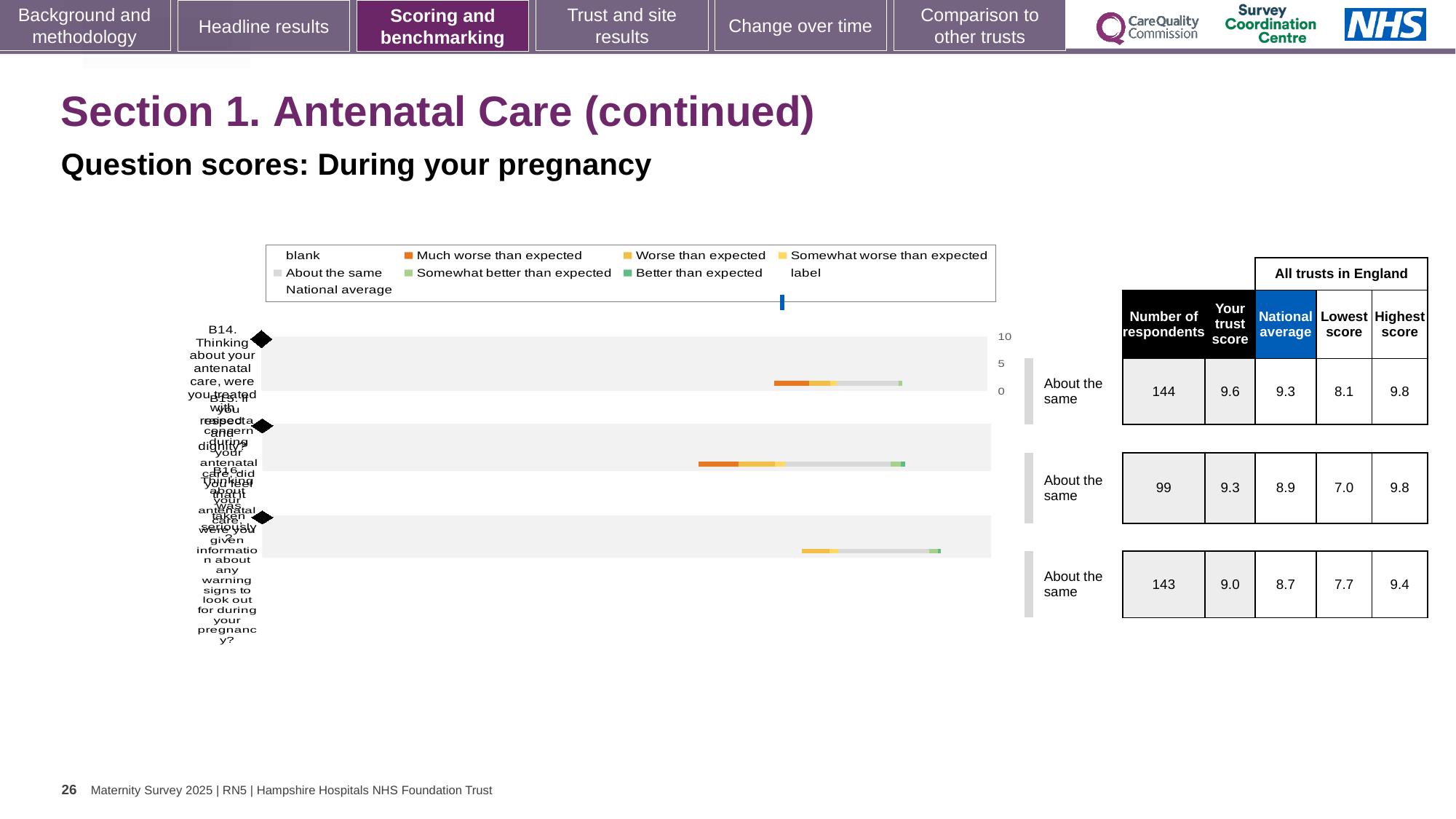
What is the difference between the trust score and the national average for question B14? 0.3 What is the national average for question B16? 8.7 What is the trust score for question B15? 9.3 What benchmark category is shown for all three questions? About the same Which question has the lowest number of respondents? B15 For question B16, which is larger: the trust score or the national average? trust score What kind of chart is shown on the slide? bar chart What is the number of respondents for question B14? 144 What is the highest score across all trusts in England for question B16? 9.4 What colour represents 'Much worse than expected' in the legend? orange How many questions (rows) are plotted in the chart? 3 Which question has the highest trust score? B14